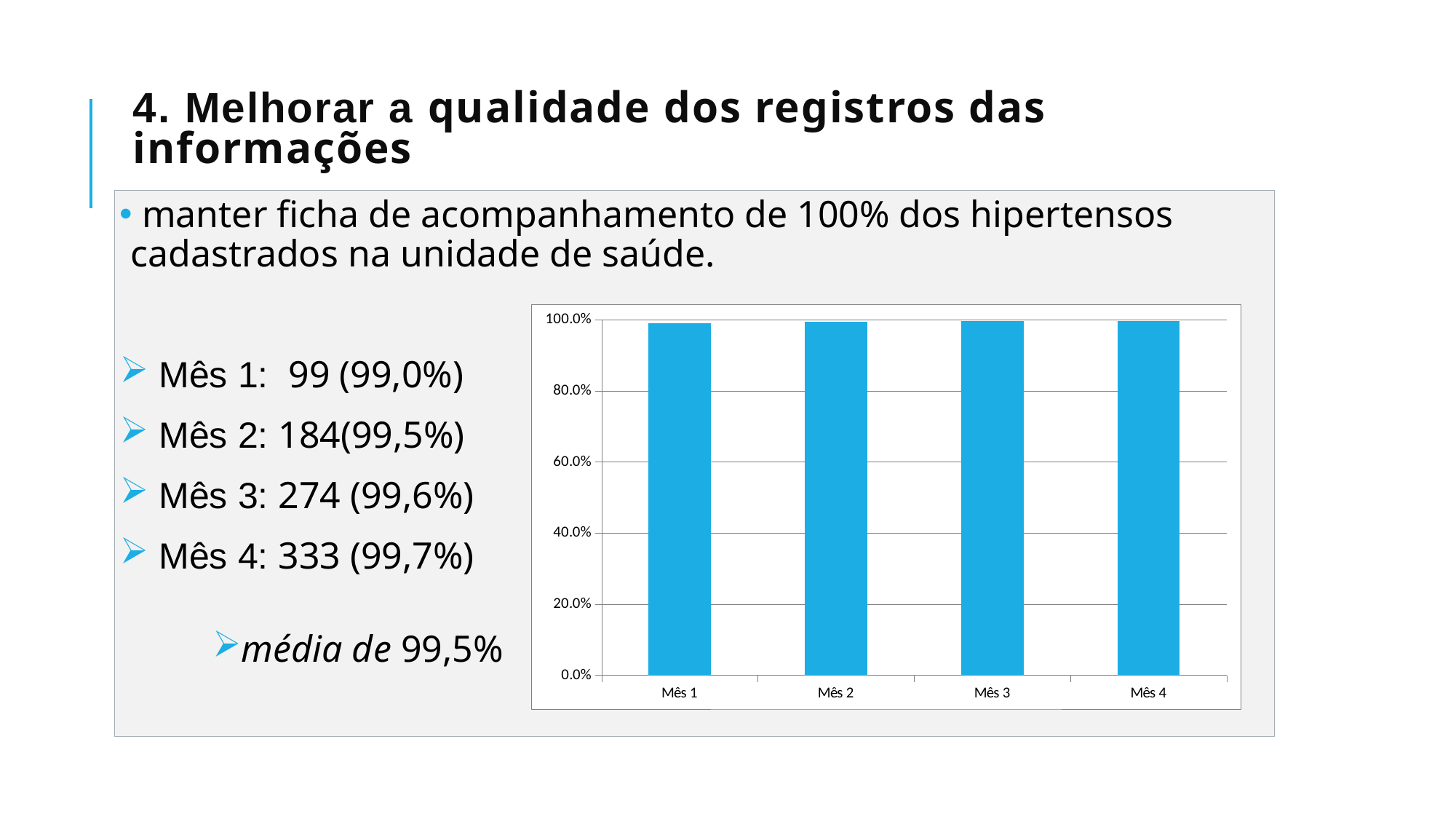
According to the slide, what percentage is shown for Mês 4? 99,7% According to the slide, what percentage is shown for Mês 3? 99,6% According to the slide, what percentage is shown for Mês 1? 99,0% According to the slide, what percentage is shown for Mês 2? 99,5% Is the value for Mês 2 greater or less than 40%? greater Is the value for Mês 3 greater or less than 20%? greater Is the value for Mês 4 greater or less than 60%? greater What kind of chart is shown on the slide? bar chart What is the highest tick value shown on the y axis? 100.0% How many categories (months) are plotted on the chart? 4 What is the label of the first category on the x axis? Mês 1